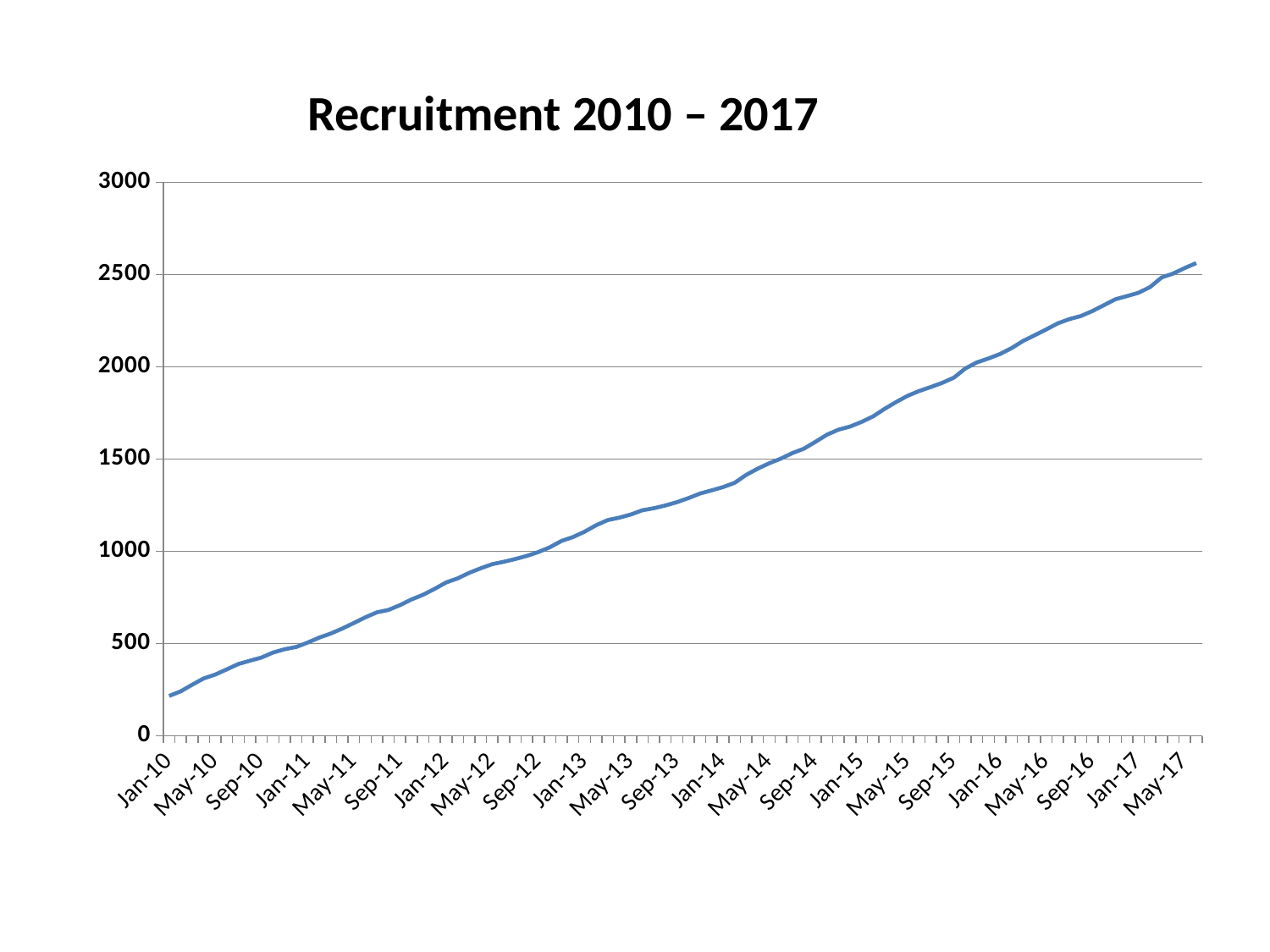
Which x-axis label has the lowest value on the line? Jan-10 What is the highest value shown on the y axis? 3000 Is the value for Jan-15 greater or less than 1500? greater Is the value for Jan-13 greater or less than 1000? greater Which x-axis label has the highest value on the line? May-17 Is the value for Jan-10 greater or less than 500? less Which is larger, the value for Jan-14 or the value for Jan-16? Jan-16 What is the title of the chart? Recruitment 2010 – 2017 Do the values rise or fall from Jan-10 to May-17? rise What kind of chart is shown on the slide? line chart